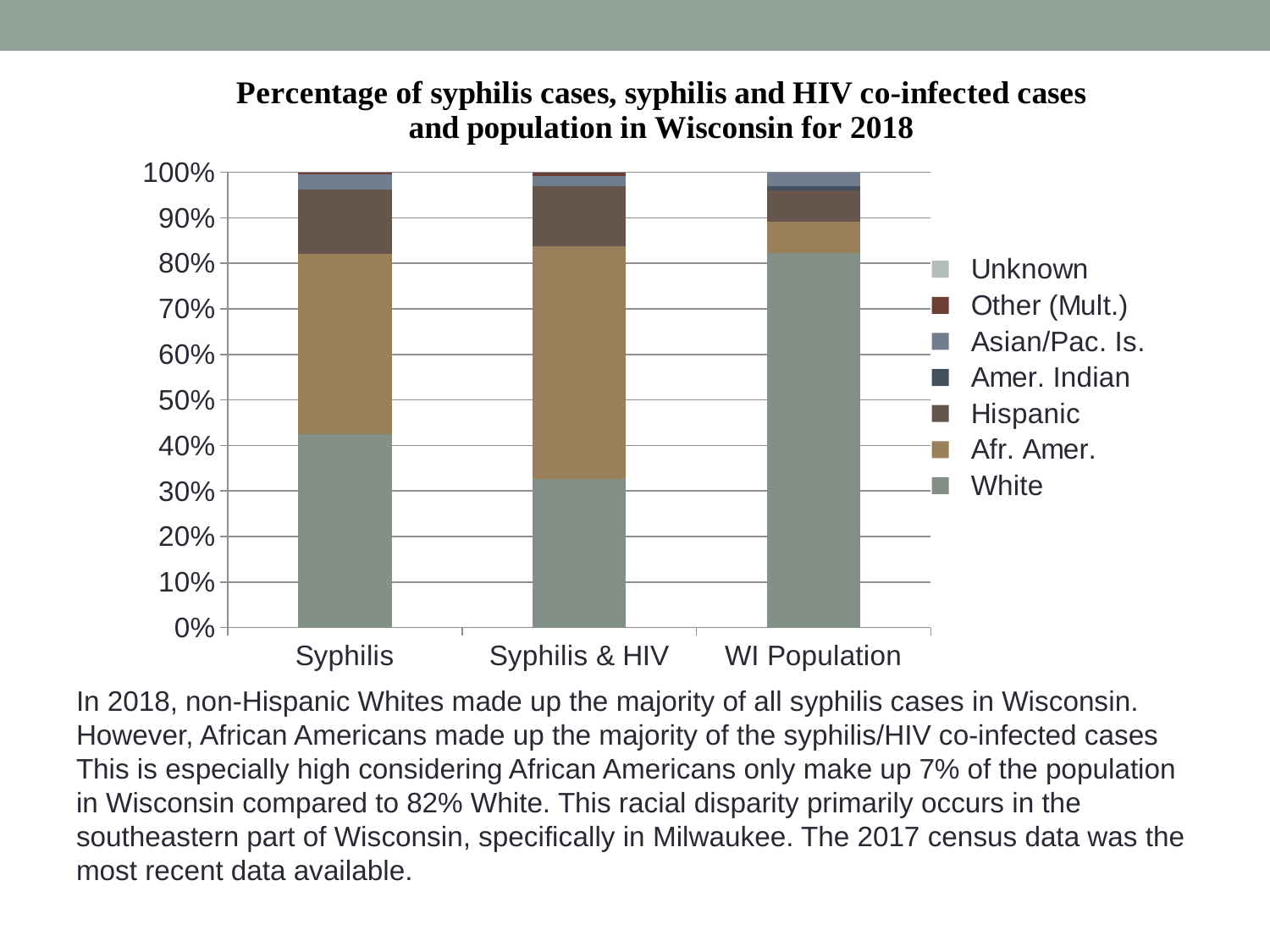
How many categories are shown along the x axis? 3 Is the value for White in the Syphilis bar greater or less than 50%? less Is the Afr. Amer. segment larger for Syphilis & HIV or for WI Population? Syphilis & HIV What is the title of the chart? Percentage of syphilis cases, syphilis and HIV co-infected cases and population in Wisconsin for 2018 How many series does the legend list? 7 Is the value for White in the WI Population bar greater or less than 70%? greater Is the White segment larger for Syphilis or for Syphilis & HIV? Syphilis What kind of chart is shown on the slide? Stacked bar chart Which series is listed last (at the bottom) in the legend? White Is the value for White in the Syphilis & HIV bar greater or less than 40%? less Which category has the smallest White segment? Syphilis & HIV Which category has the largest White segment? WI Population